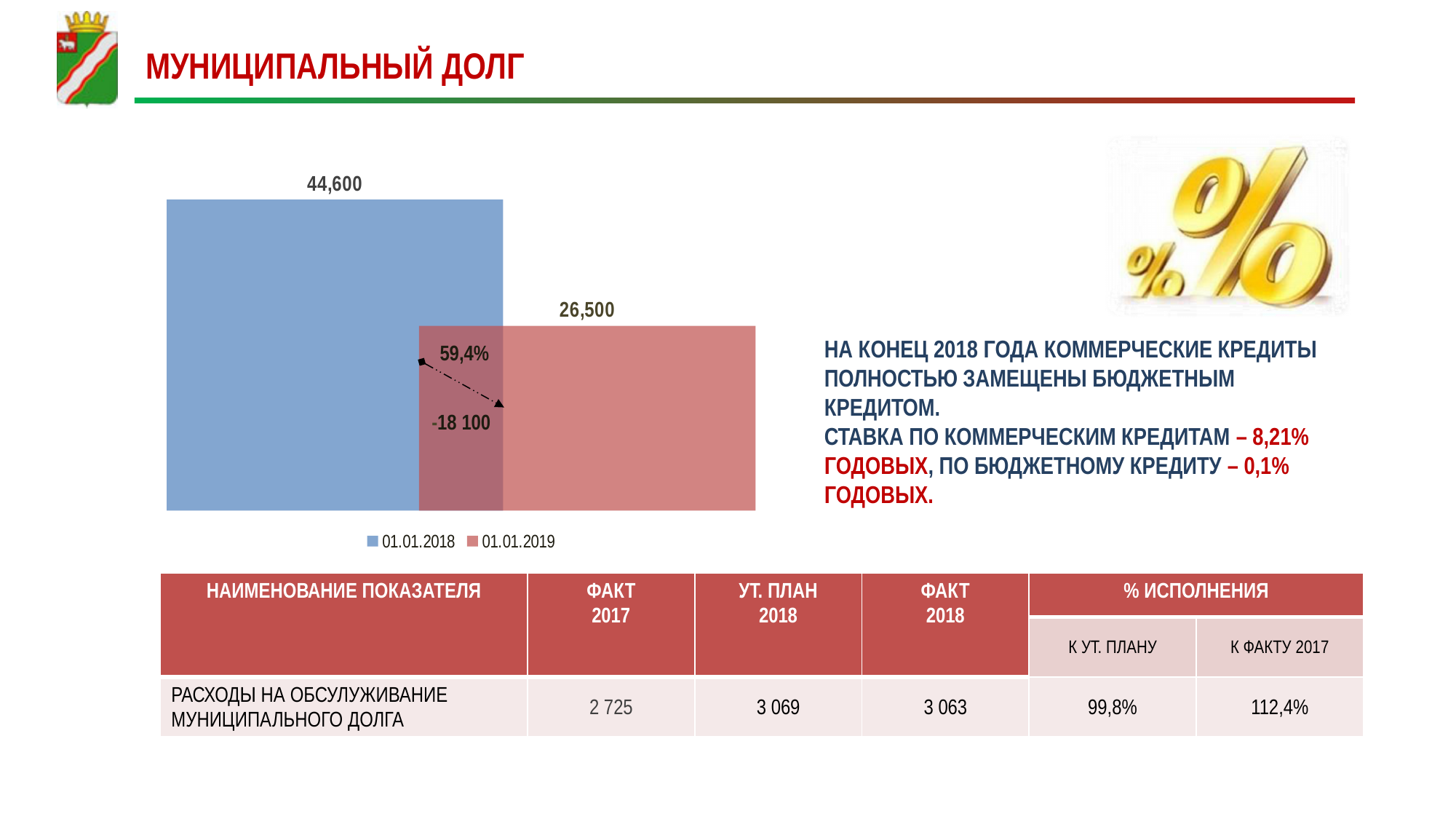
Which series has the highest value on the bar chart? 01.01.2018 What is the value shown for 01.01.2019 on the bar chart? 26,500 How many series does the legend of the bar chart list? 2 Which series has the higher value on the bar chart, 01.01.2018 or 01.01.2019? 01.01.2018 What colour is the bar for 01.01.2019 on the chart? Red Which series has the lowest value on the bar chart? 01.01.2019 What change value is annotated between the two bars on the chart? -18 100 Do the values on the bar chart rise or fall from 01.01.2018 to 01.01.2019? Fall What is the difference between the 01.01.2018 value and the 01.01.2019 value on the bar chart? 18,100 What is the value shown for 01.01.2018 on the bar chart? 44,600 What percentage is annotated between the two bars on the chart? 59,4% What kind of chart is shown on the slide? Bar chart